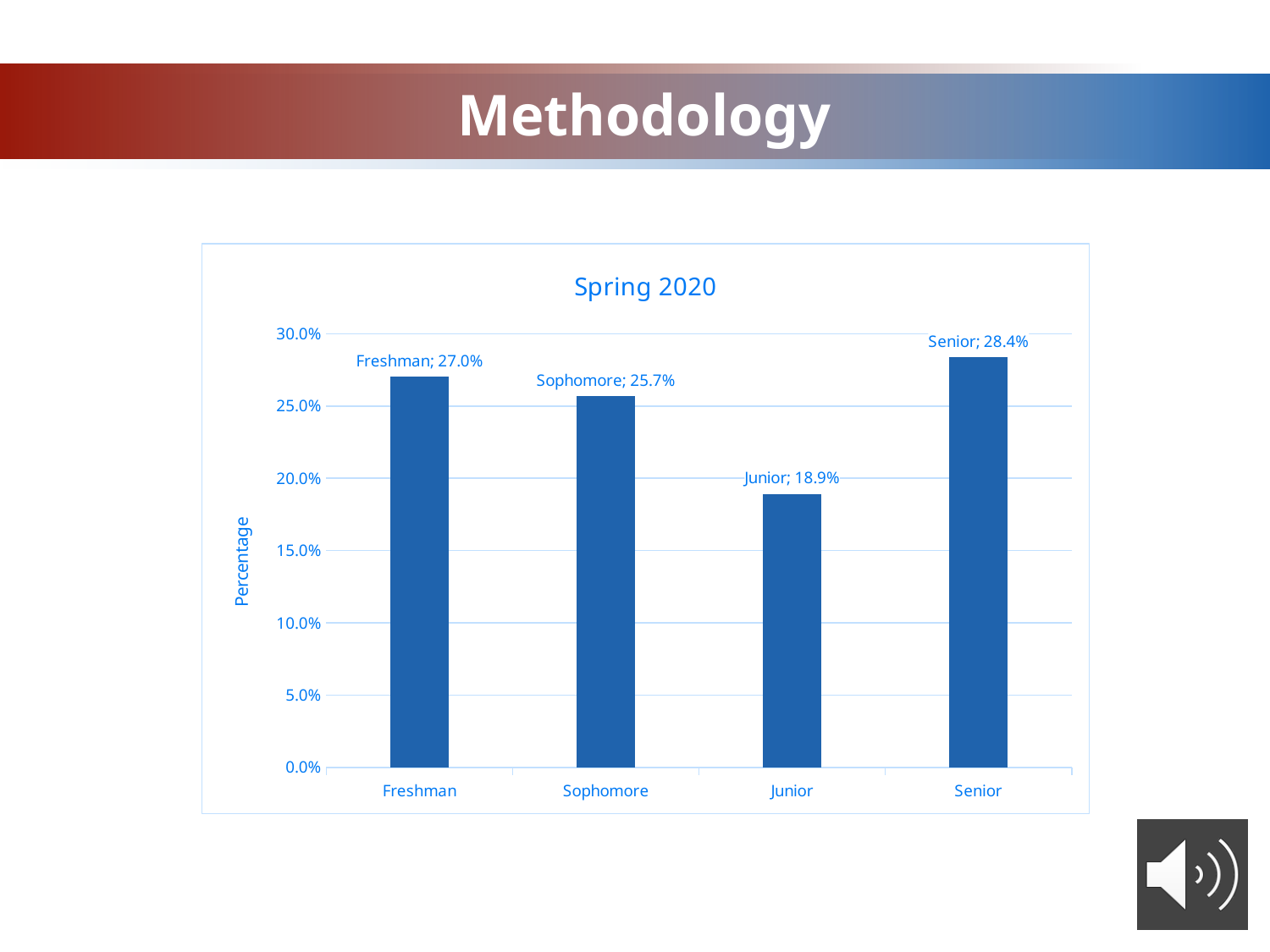
How many categories are shown on the x axis? 4 What kind of chart is shown on the slide? bar chart What is the value for Freshman? 27.0% Which category has the lowest value? Junior What is the title of the chart? Spring 2020 Is the value for Junior greater or less than 20.0%? less Which is larger, the value for Sophomore or the value for Junior? Sophomore Which category has the highest value? Senior What is the value for Junior? 18.9% What is the value for Senior? 28.4% What is the difference between the Freshman and Sophomore values? 1.3% What is the difference between the Senior and Junior values? 9.5%